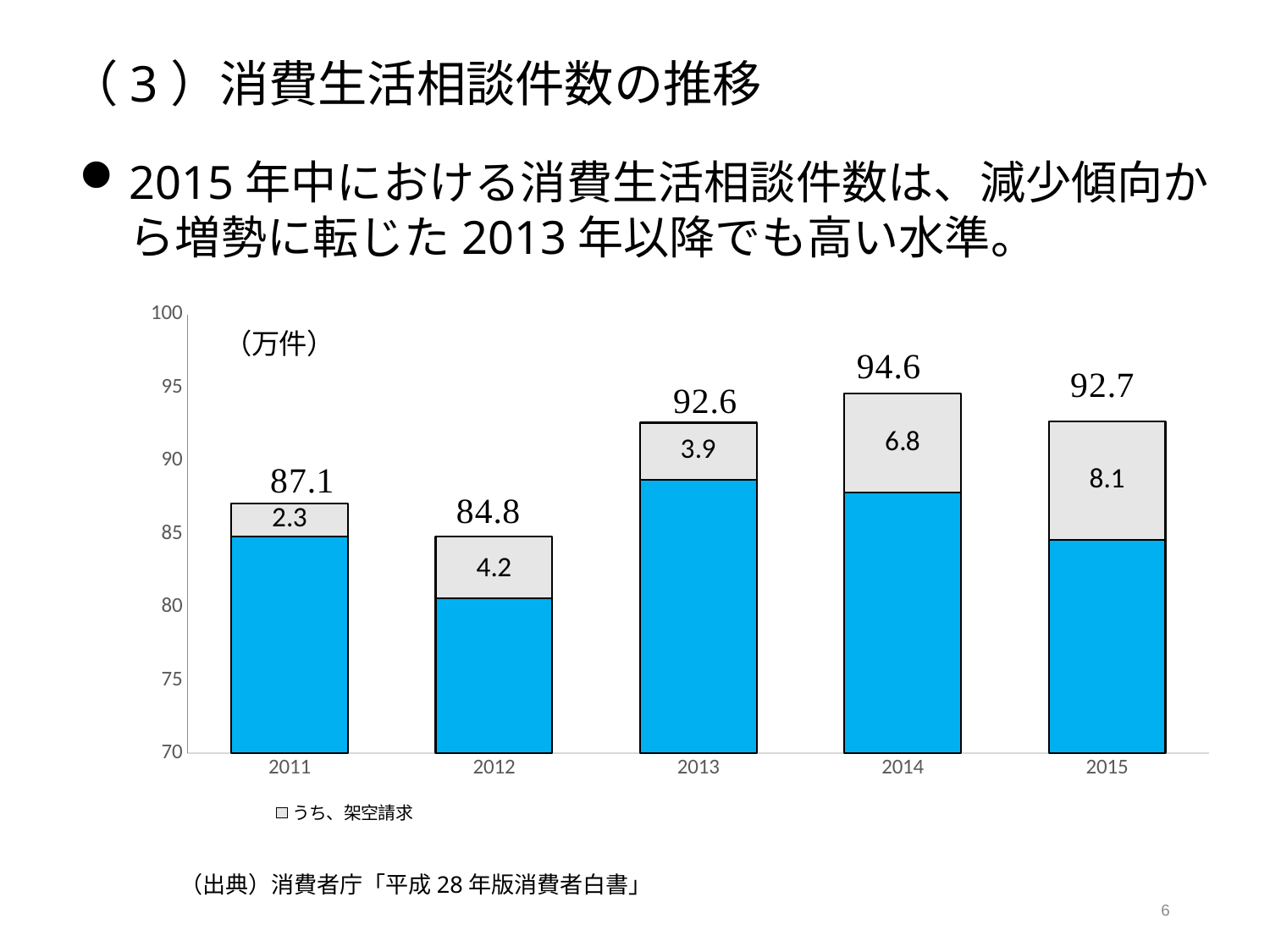
What unit is indicated in the upper left of the chart? 万件 What is the difference between the total for 2014 and the total for 2012? 9.8 Which year has the highest total number of consultations? 2014 What is the value of the 架空請求 (grey) segment for 2015? 8.1 What is the value of the 架空請求 segment for 2012? 4.2 What kind of chart is shown on the slide? bar chart Which year has the lowest total number of consultations? 2012 What is the total number of consumer consultations (万件) shown for 2014? 94.6 Which year has the largest 架空請求 segment? 2015 How many years are shown on the x axis? 5 Is the total for 2012 greater or less than 85? less Which year has the larger total, 2011 or 2012? 2011